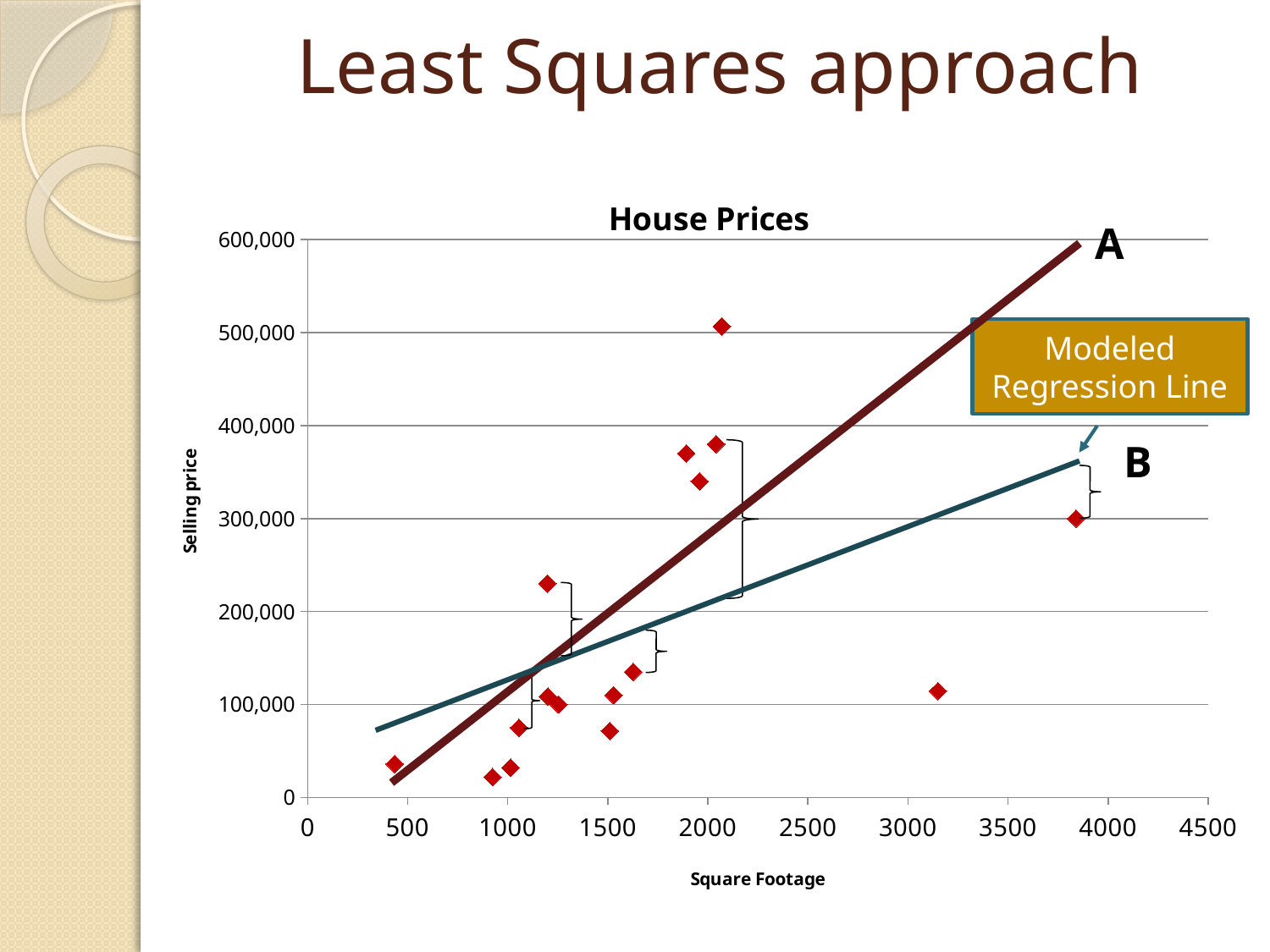
What kind of chart is shown on the slide? Scatter chart Which line does the callout 'Modeled Regression Line' point to? B Is the selling price of the point at roughly 3150 square feet greater or less than 200,000? less What is the maximum value shown on the y axis? 600,000 Is the selling price of the house with the largest square footage (around 3850) greater or less than 400,000? less Is the lowest plotted selling price greater or less than 100,000? less Do selling prices generally rise or fall as square footage increases? rise Which of the two lines, A or B, is steeper? A What is the label of the x axis of the chart? Square Footage